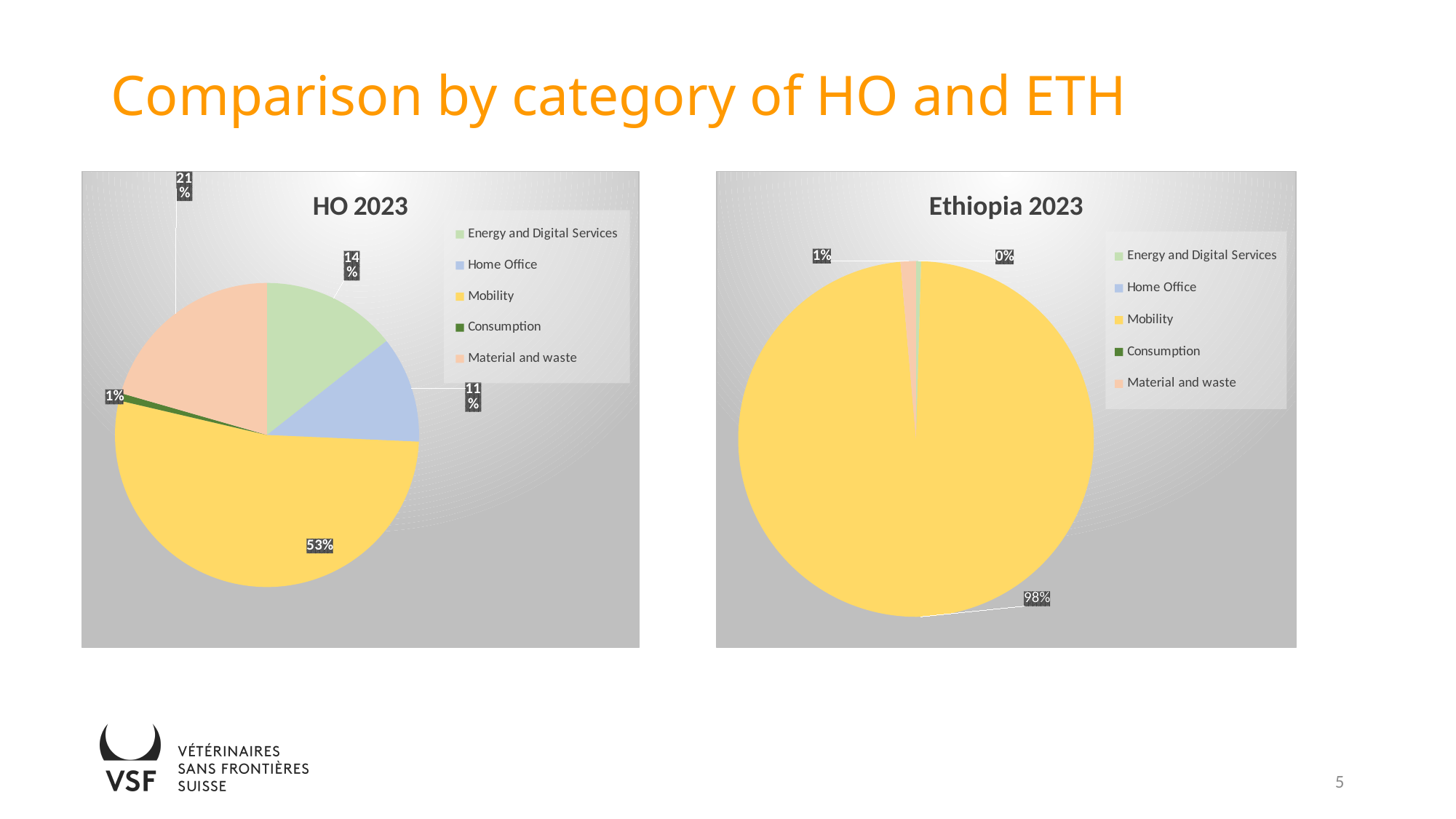
In the HO 2023 chart, what share does Home Office account for? 11% In the HO 2023 chart, what share does Consumption account for? 1% In the HO 2023 chart, which category has the largest share? Mobility In the HO 2023 chart, what share does Mobility account for? 53% In the HO 2023 chart, what is the difference in percentage points between Material and waste and Home Office? 10 In the HO 2023 chart, which category has the smallest share? Consumption In the HO 2023 chart, what share does Energy and Digital Services account for? 14% How many categories does the legend of the HO 2023 chart list? 5 In the Ethiopia 2023 chart, what share does Mobility account for? 98% In the Ethiopia 2023 chart, what share does Material and waste account for? 1% In the HO 2023 chart, what share does Material and waste account for? 21% What type of chart is the Ethiopia 2023 chart? Pie chart